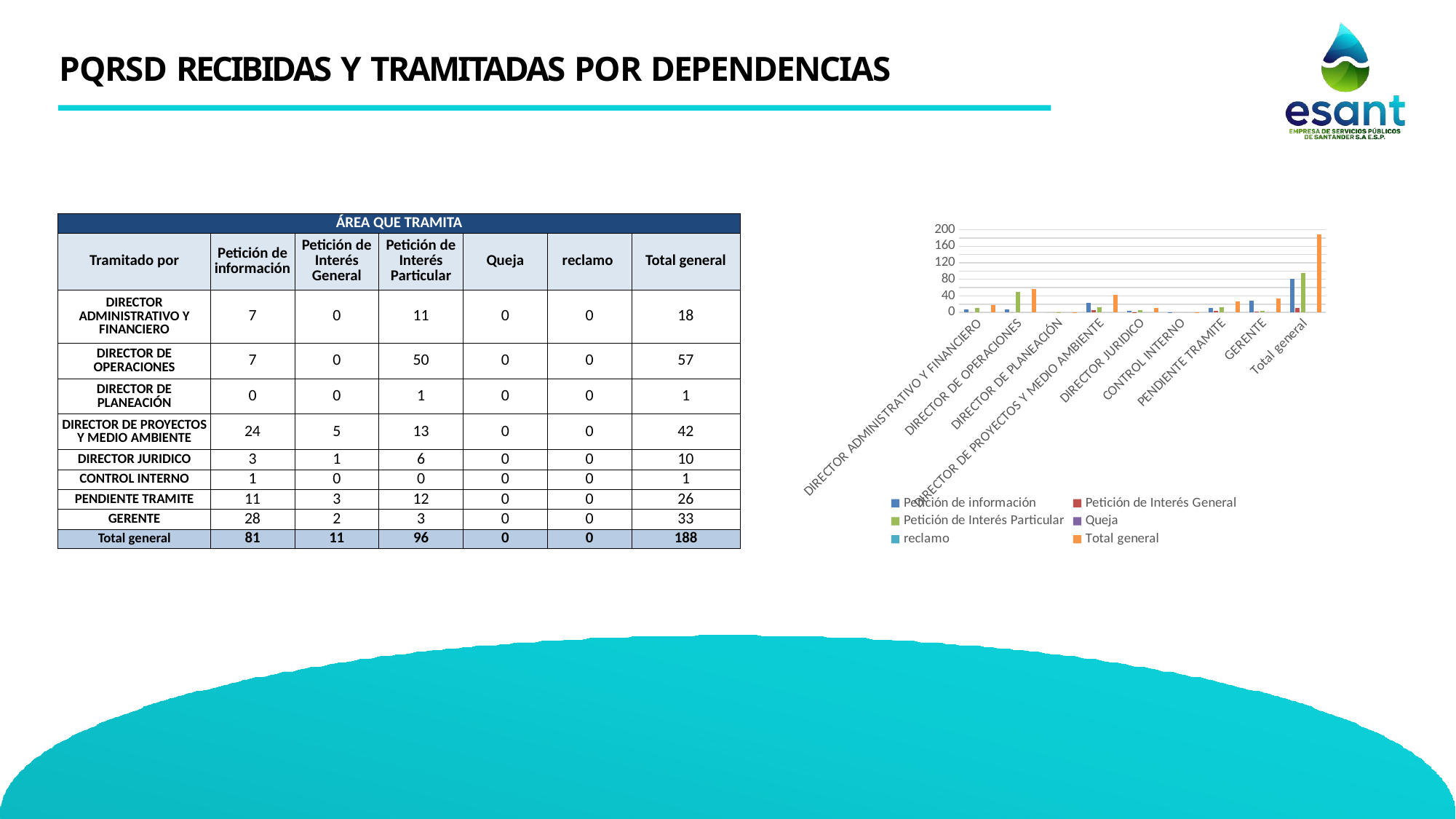
In the chart, which is larger: the Total general bar for DIRECTOR DE OPERACIONES or for GERENTE? DIRECTOR DE OPERACIONES How many categories are shown along the x axis of the chart? 9 In the chart, is the Petición de Interés Particular bar for the Total general category greater or less than 80? greater In the chart, is the Total general bar for DIRECTOR DE OPERACIONES greater or less than 40? greater What colour represents the Total general series in the chart legend? orange What kind of chart is shown on the right of the slide? bar chart In the chart, is the Total general bar for DIRECTOR ADMINISTRATIVO Y FINANCIERO greater or less than 40? less Which category has the tallest bar in the chart? Total general How many series does the chart legend list? 6 Excluding the Total general category, which dependency has the tallest Total general bar in the chart? DIRECTOR DE OPERACIONES